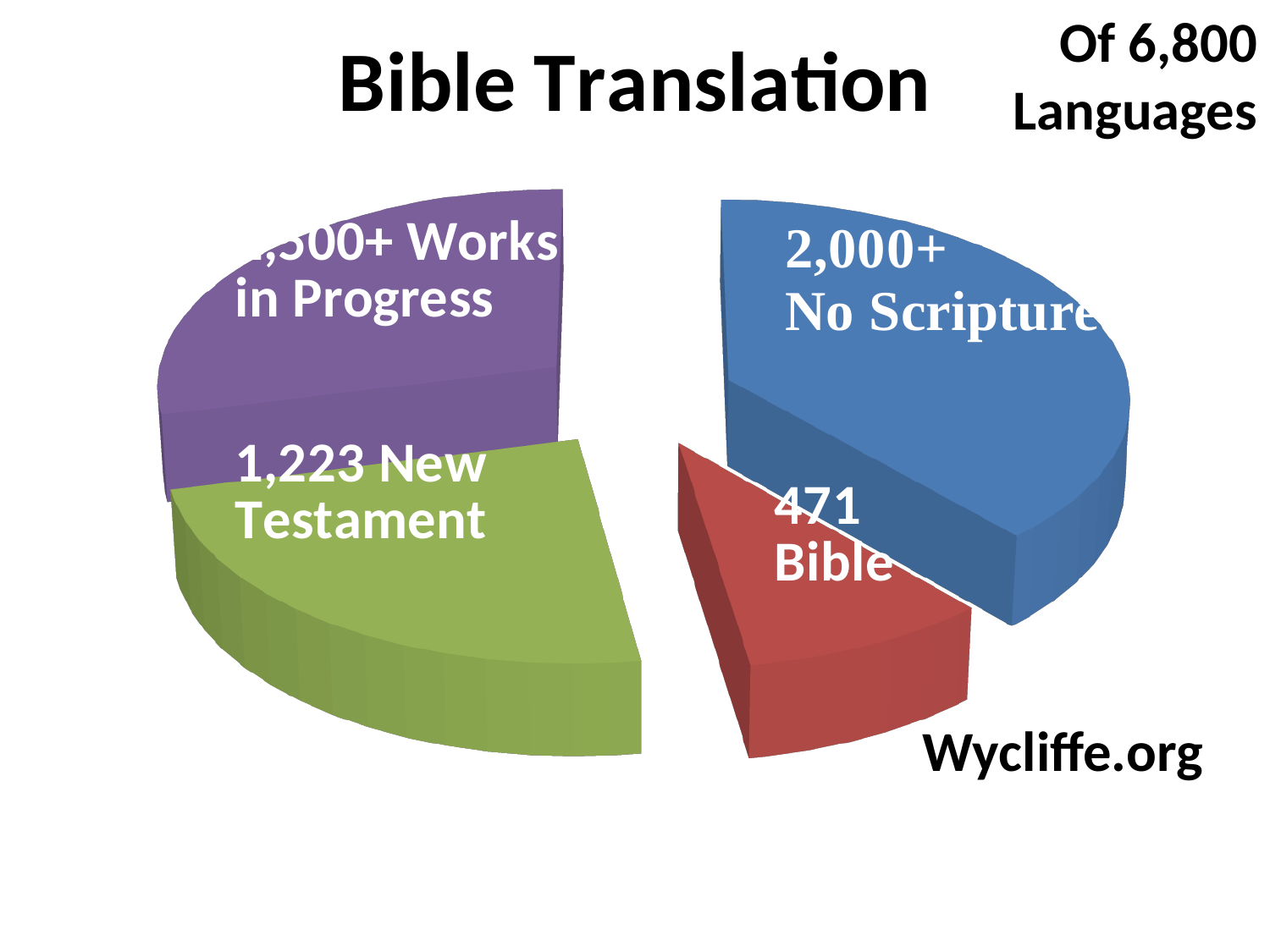
Which is larger, the No Scripture slice or the New Testament slice? No Scripture Which slice of the pie chart is the smallest? Bible What colour is the Bible slice? red What is the value shown for the New Testament slice? 1,223 What kind of chart is shown on the slide? pie chart What is the value shown for the No Scripture slice? 2,000+ What is the difference between the New Testament value and the Bible value? 752 How many slices does the pie chart have? 4 Which slice of the pie chart is the largest? No Scripture Which is larger, the New Testament slice or the Bible slice? New Testament What is the value shown for the Bible slice? 471 What is the title of the chart? Bible Translation